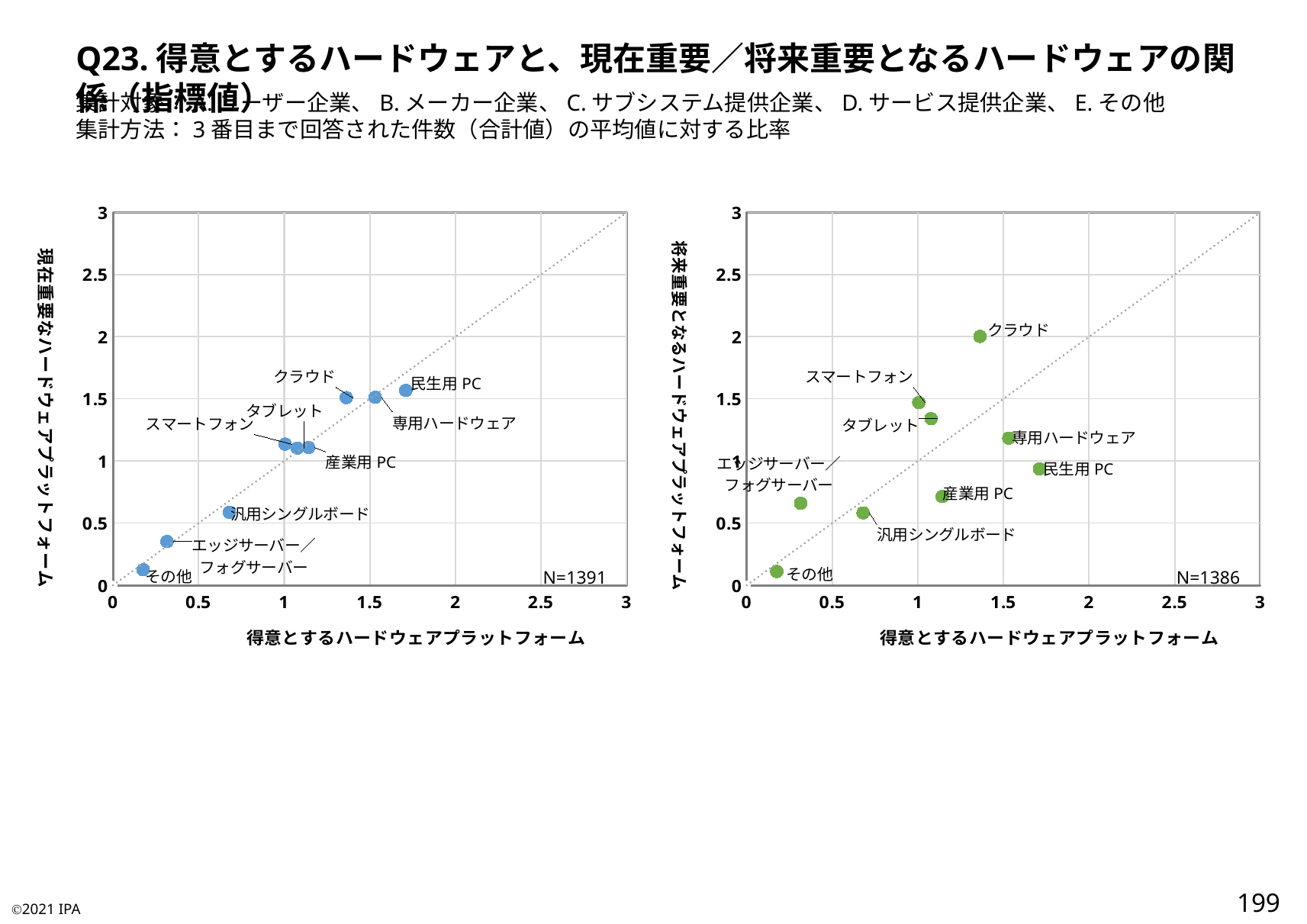
On the right chart (将来重要となるハードウェアプラットフォーム), which point has the lowest vertical-axis value? その他 On the left chart (現在重要なハードウェアプラットフォーム), is the vertical-axis value for クラウド greater or less than 1? greater What is the N value shown on the left chart (現在重要なハードウェアプラットフォーム)? N=1391 On the left chart (現在重要なハードウェアプラットフォーム), is the vertical-axis value for 汎用シングルボード greater or less than 1? less On the right chart (将来重要となるハードウェアプラットフォーム), which point has the highest vertical-axis value? クラウド On the right chart (将来重要となるハードウェアプラットフォーム), which has the larger vertical-axis value, クラウド or 民生用 PC? クラウド What is the N value shown on the right chart (将来重要となるハードウェアプラットフォーム)? N=1386 What kind of chart is the left chart (現在重要なハードウェアプラットフォーム)? scatter chart How many data points are plotted on the left chart (現在重要なハードウェアプラットフォーム)? 9 How many data points are plotted on the right chart (将来重要となるハードウェアプラットフォーム)? 9 On the right chart (将来重要となるハードウェアプラットフォーム), is the horizontal-axis value for 民生用 PC greater or less than 1.5? greater On the left chart (現在重要なハードウェアプラットフォーム), which point has the lowest vertical-axis value? その他